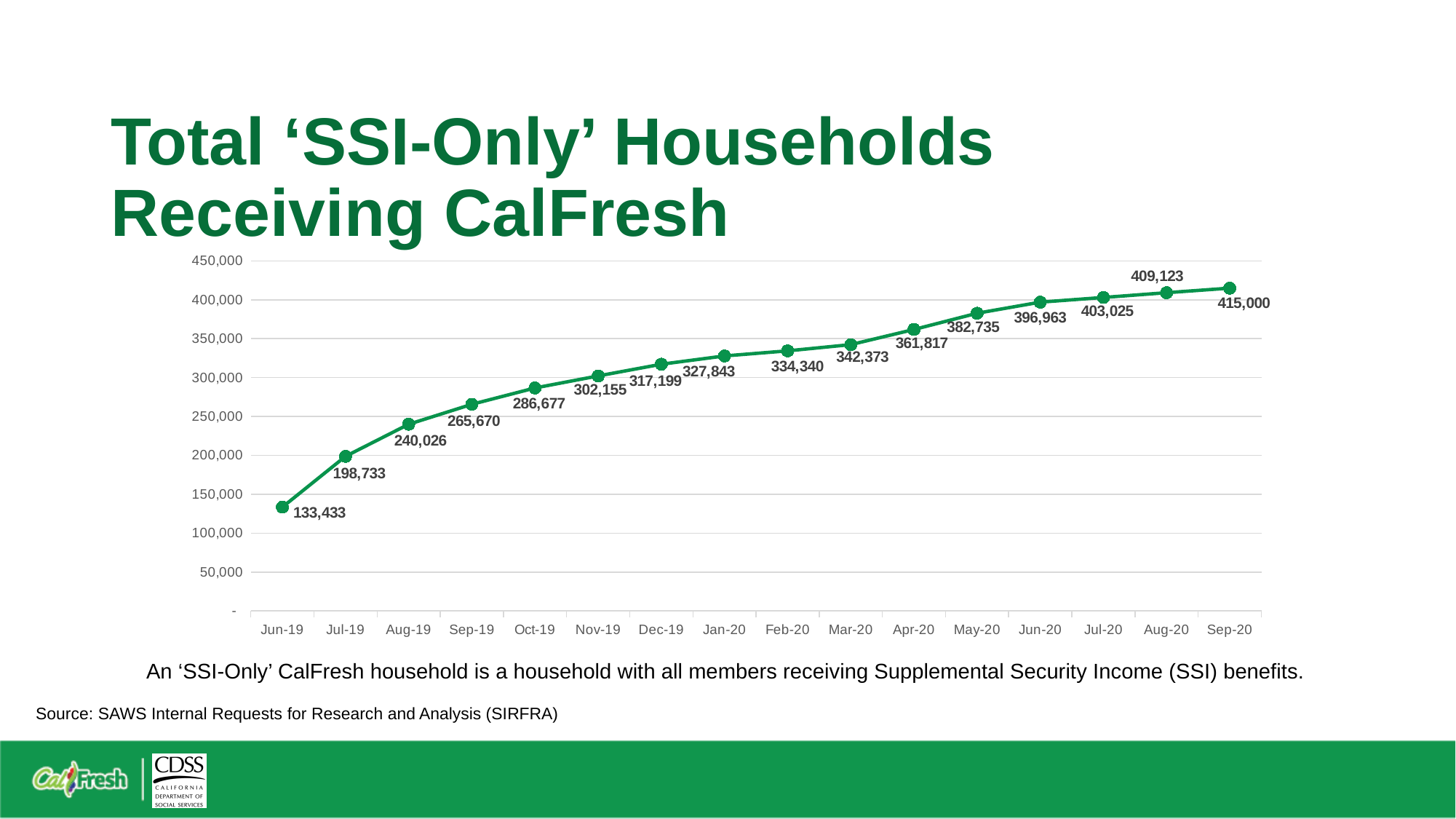
Which month has the lowest value? Jun-19 What is the value for Sep-20? 415,000 What is the difference between the Sep-20 value and the Jun-19 value? 281,567 Which is larger, the value for Dec-19 or the value for Apr-20? Apr-20 Do the values rise or fall from Jun-19 to Sep-20? rise Which month has the highest value? Sep-20 What is the value for Jun-19? 133,433 How many data points are plotted on the chart? 16 What is the increase from Jun-19 to Jul-19? 65,300 What kind of chart is shown on the slide? line chart What is the value for Mar-20? 342,373 Is the value for Jun-20 greater or less than 350,000? greater